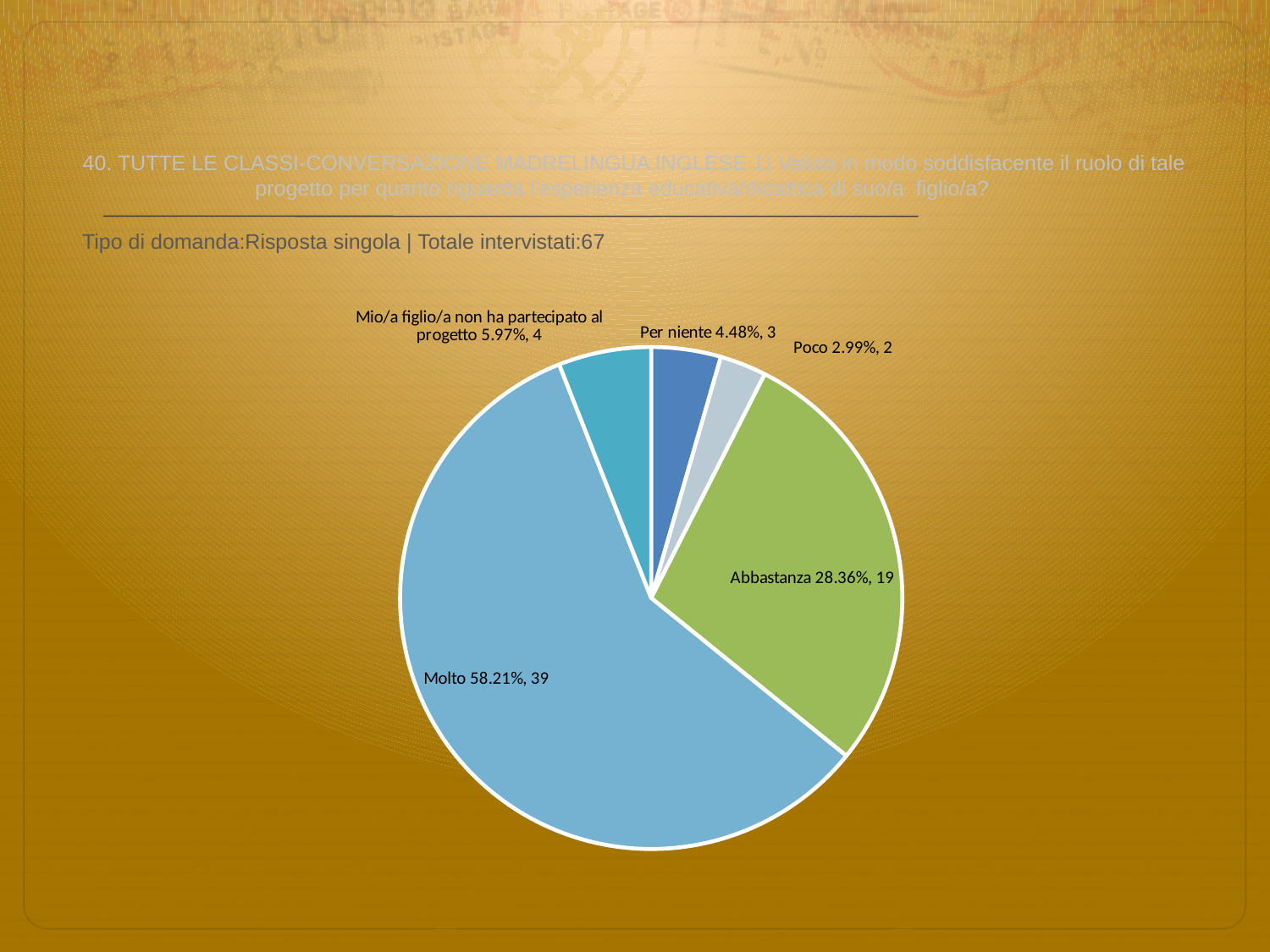
How many slices does the pie chart have? 5 How many respondents answered 'Abbastanza'? 19 What is the total number of respondents stated on the slide? 67 How many respondents answered 'Mio/a figlio/a non ha partecipato al progetto'? 4 Which category has the largest slice? Molto How many respondents answered 'Per niente'? 3 What percentage share does the 'Molto' slice have? 58.21% What percentage share does the 'Poco' slice have? 2.99% What kind of chart is shown on the slide? pie chart Which category has the smallest slice? Poco Which has more respondents, 'Per niente' or 'Mio/a figlio/a non ha partecipato al progetto'? Mio/a figlio/a non ha partecipato al progetto What is the difference in respondent count between 'Molto' and 'Abbastanza'? 20